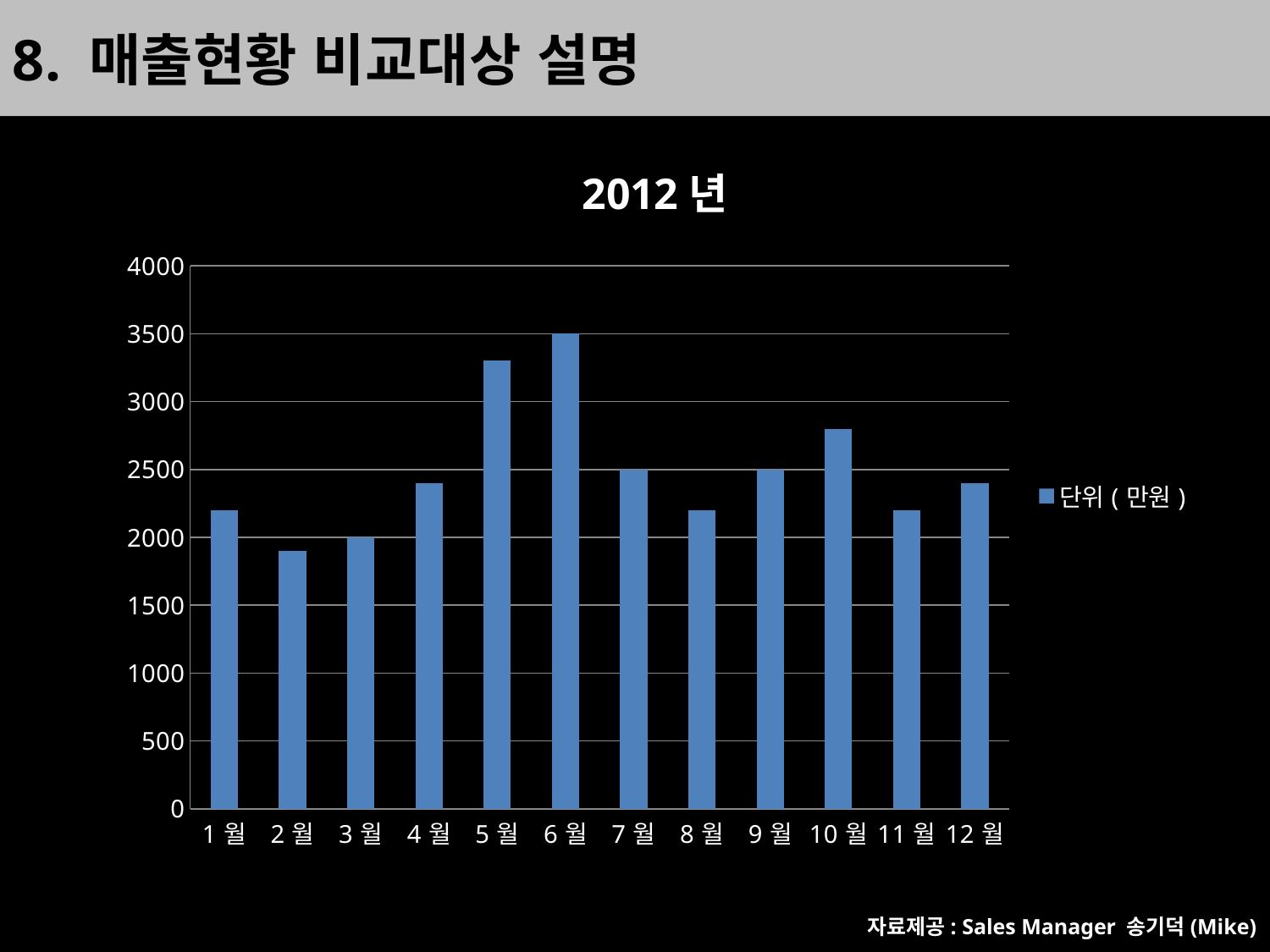
What is the value for 6 월? 3500 How many months (categories) are plotted on the x axis? 12 Which month has the lowest bar? 2 월 Which month has the highest bar? 6 월 What is the title of the chart? 2012 년 Is the value for 2 월 greater or less than 2000? less Which is larger, the value for 5 월 or the value for 10 월? 5 월 What is the difference between the values for 6 월 and 7 월? 1000 How many series does the legend list? 1 Is the value for 10 월 greater or less than 2500? greater What is the value for 3 월? 2000 What kind of chart is shown on the slide? bar chart